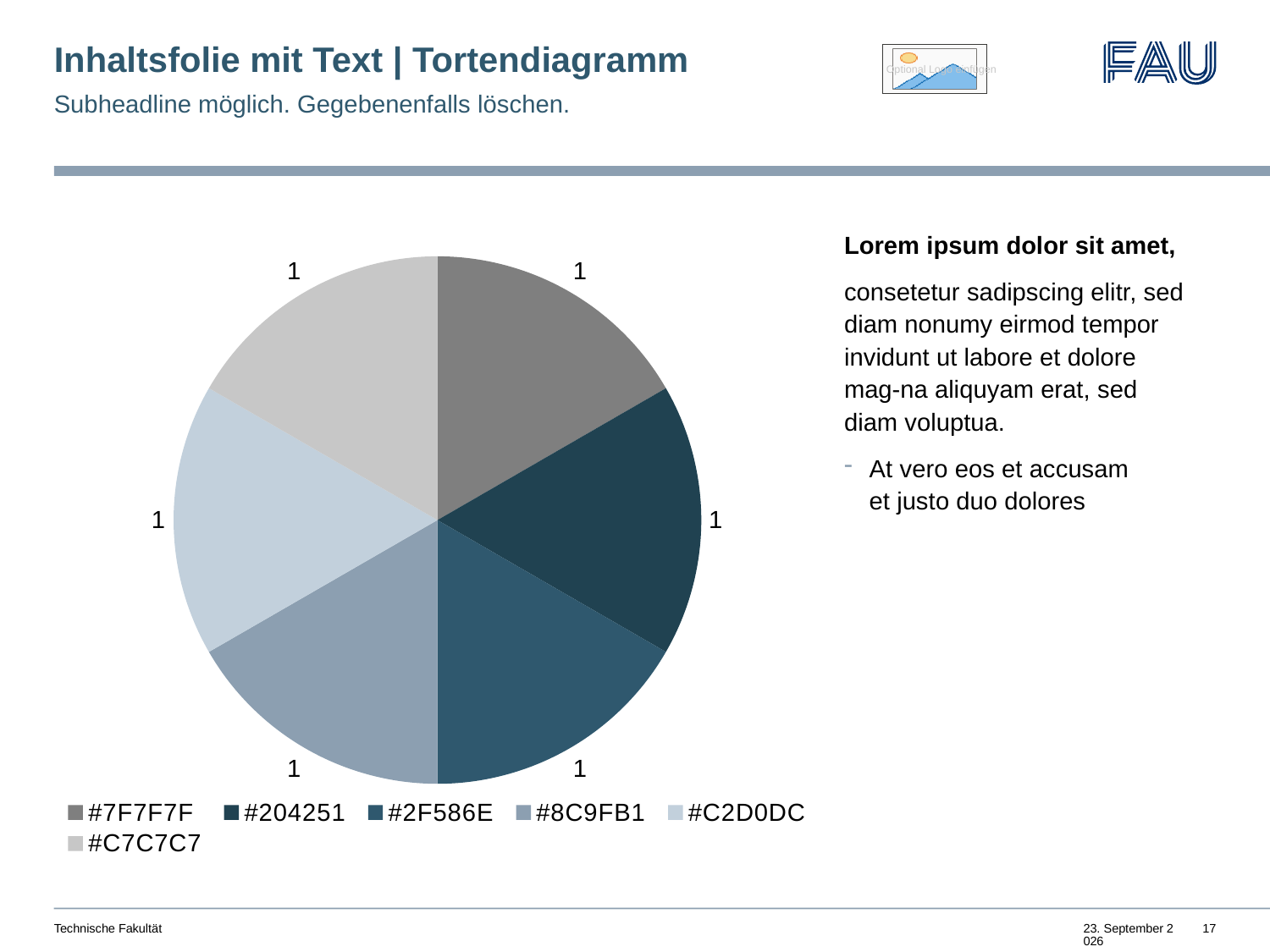
How many entries does the legend of the pie chart list? 6 What is the value of the #C7C7C7 slice in the pie chart? 1 Do all slices of the pie chart have the same value? yes What kind of chart is shown on the slide? pie chart What is the last entry listed in the legend of the pie chart? #C7C7C7 How many slices does the pie chart have? 6 What is the total of all slice values in the pie chart? 6 What share of the pie does the #C2D0DC slice represent? 1/6 What is the difference between the values of the #2F586E slice and the #8C9FB1 slice? 0 What is the first entry listed in the legend of the pie chart? #7F7F7F What is the value of the #7F7F7F slice in the pie chart? 1 What is the value of the #204251 slice in the pie chart? 1